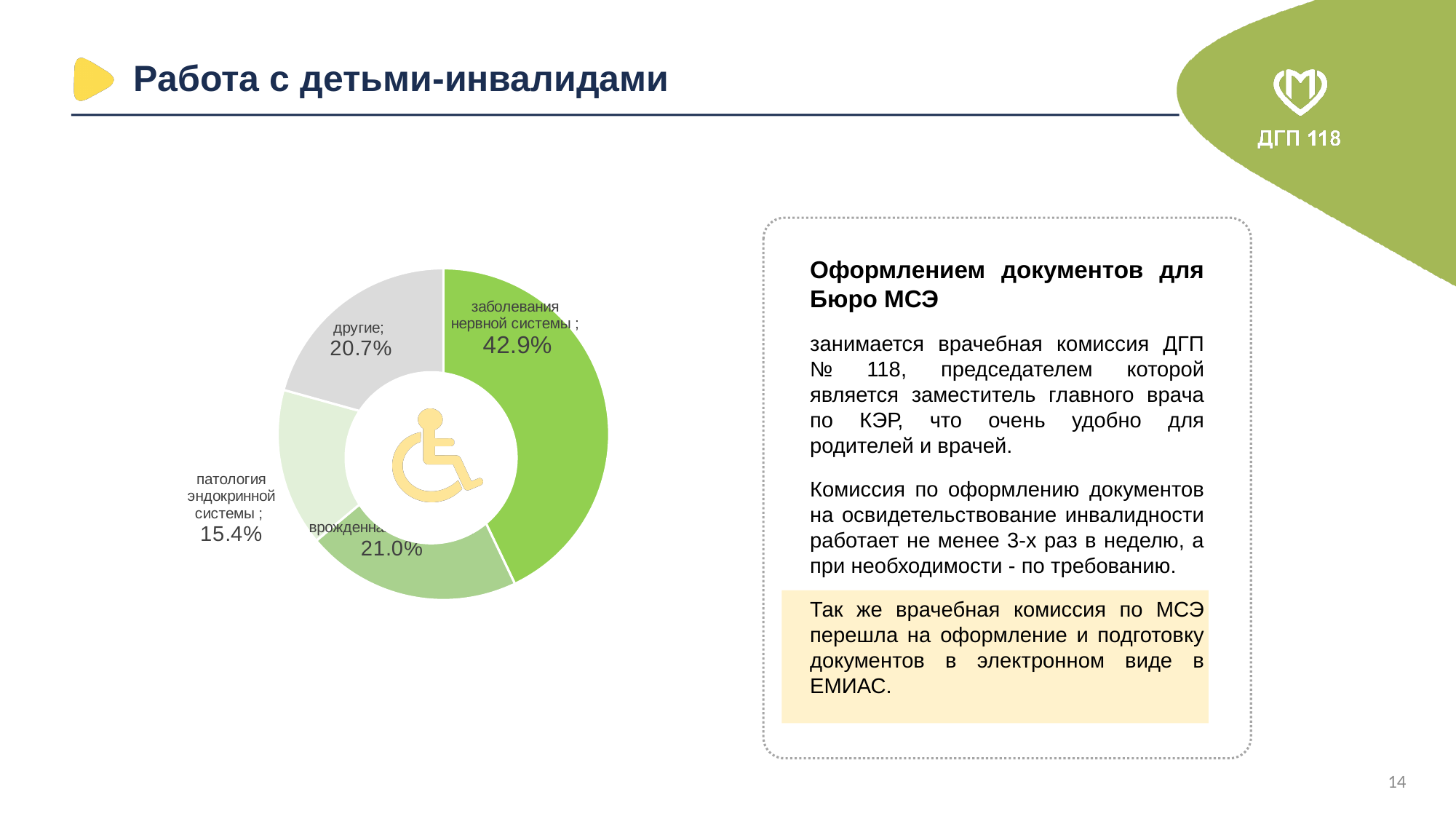
How many slices does the chart have? 4 What kind of chart is shown on the slide? pie (doughnut) chart What percentage is shown for the slice 'патология эндокринной системы'? 15.4% What percentage is shown for the slice 'заболевания нервной системы'? 42.9% What colour is the largest slice of the chart? green What share of the whole does the slice 'заболевания нервной системы' represent? 42.9% Which slice of the chart is the smallest? патология эндокринной системы What is the difference in percentage points between 'другие' and 'патология эндокринной системы'? 5.3 Which slice of the chart is the largest? заболевания нервной системы What percentage is shown for the slice 'другие'? 20.7% Which is larger: the slice 'другие' or the slice 'патология эндокринной системы'? другие What is the difference in percentage points between 'заболевания нервной системы' and 'другие'? 22.2